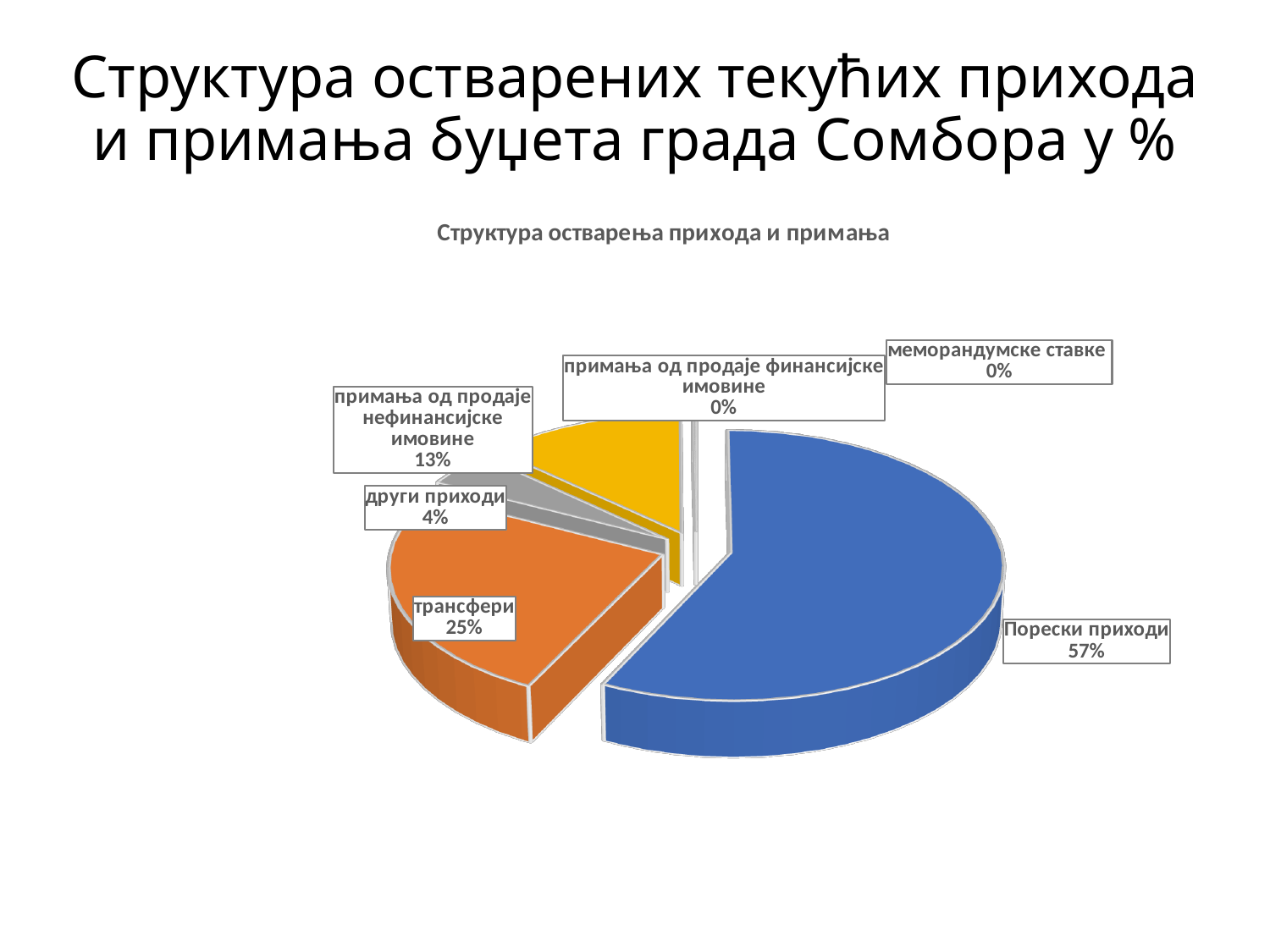
What share of the pie does Порески приходи have? 57% Which category has the largest slice of the pie? Порески приходи What is the title of the chart? Структура остварења прихода и примања What kind of chart is shown on the slide? pie chart What is the difference in percentage points between примања од продаје нефинансијске имовине and други приходи? 9 What is the difference in percentage points between Порески приходи and трансфери? 32 What share of the pie does меморандумске ставке have? 0% What share of the pie does други приходи have? 4% How many categories are shown in the pie chart? 6 Which is larger, трансфери or примања од продаје нефинансијске имовине? трансфери